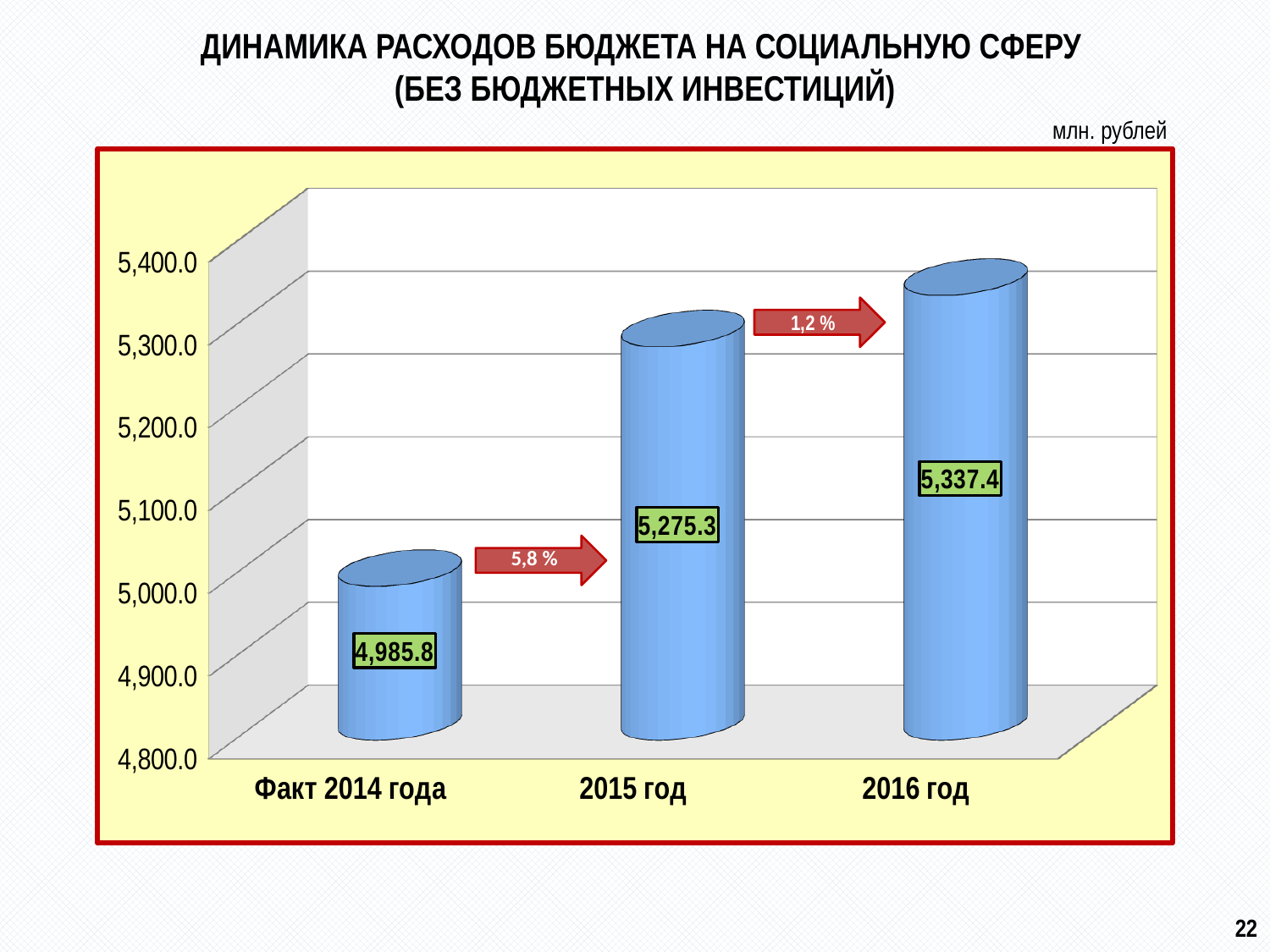
Do the values rise or fall from Факт 2014 года to 2016 год? rise What is the difference between the values for 2015 год and Факт 2014 года? 289.5 Which category has the lowest value? Факт 2014 года How many categories are shown on the x axis? 3 Is the value for Факт 2014 года greater or less than 5,000.0? less What is the value for 2016 год? 5,337.4 What is the value for 2015 год? 5,275.3 What is the difference between the values for 2016 год and 2015 год? 62.1 Which category has the highest value? 2016 год What is the value for Факт 2014 года? 4,985.8 What kind of chart is shown on the slide? bar chart Which is larger, the value for 2015 год or the value for Факт 2014 года? 2015 год